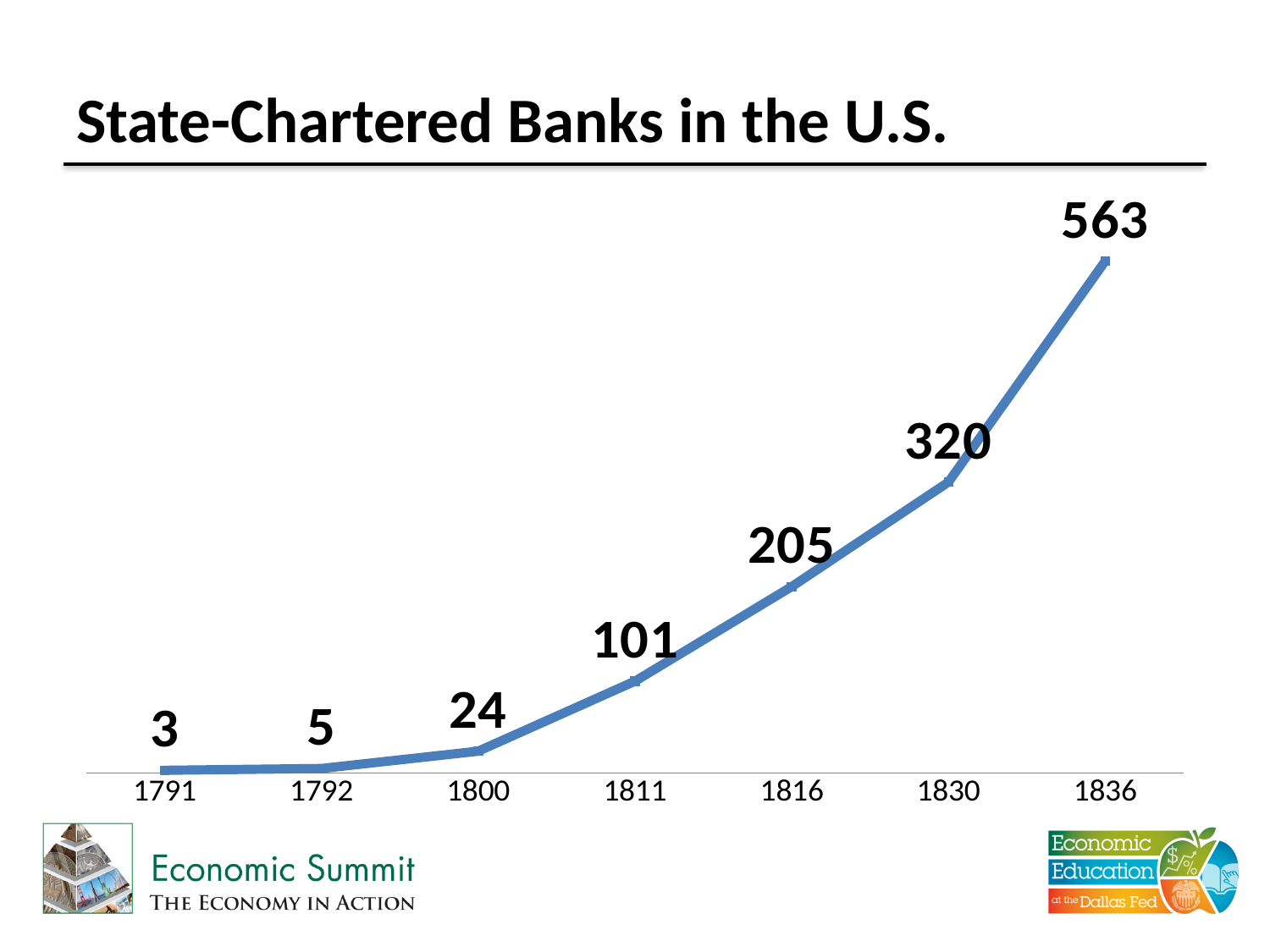
Which year has more state-chartered banks, 1800 or 1816? 1816 What is the difference between the number of banks in 1816 and in 1811? 104 How many years are plotted on the chart? 7 What is the number of state-chartered banks in 1836? 563 What is the number of state-chartered banks in 1811? 101 What is the number of state-chartered banks in 1791? 3 What is the number of state-chartered banks in 1830? 320 What is the difference between the number of banks in 1836 and in 1830? 243 What kind of chart is shown on the slide? Line chart Which year has the lowest number of state-chartered banks? 1791 Which year has the highest number of state-chartered banks? 1836 Do the values rise or fall from 1791 to 1836? Rise